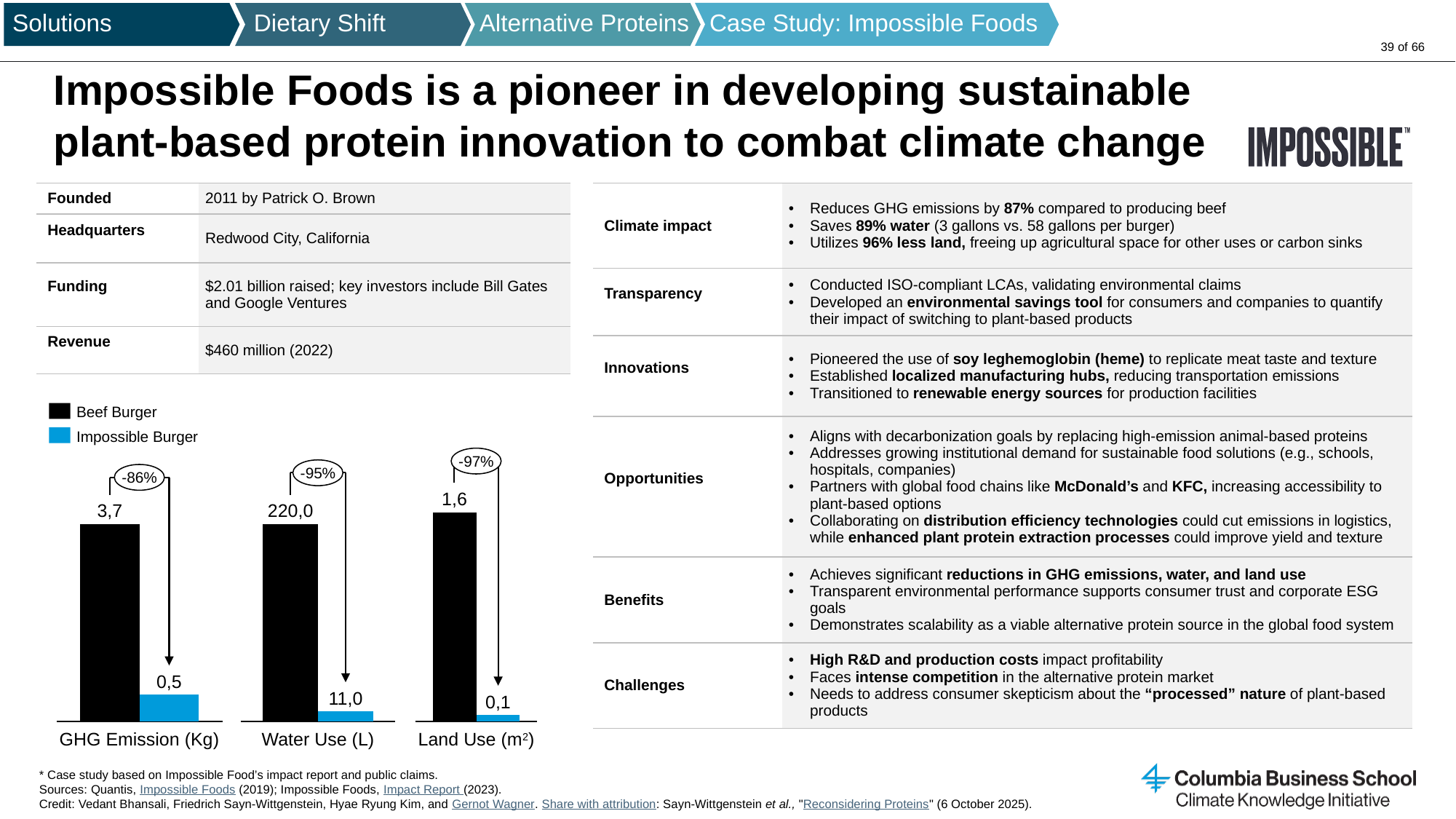
What is the Water Use (L) value for the Beef Burger? 220,0 What percentage reduction is shown above the Water Use (L) bars? -95% What is the Land Use (m²) value for the Impossible Burger? 0,1 What is the Water Use (L) value for the Impossible Burger? 11,0 What is the difference between the Beef Burger and Impossible Burger values for Land Use (m²)? 1,5 What kind of chart is used to compare the Beef Burger and Impossible Burger? Bar chart How many series does the chart legend list? 2 What is the GHG Emission (Kg) value for the Impossible Burger? 0,5 What is the GHG Emission (Kg) value for the Beef Burger? 3,7 What percentage reduction is shown above the Land Use (m²) bars? -97% Which colour represents the Impossible Burger in the chart? Blue Which has the larger GHG Emission (Kg) value, the Beef Burger or the Impossible Burger? Beef Burger